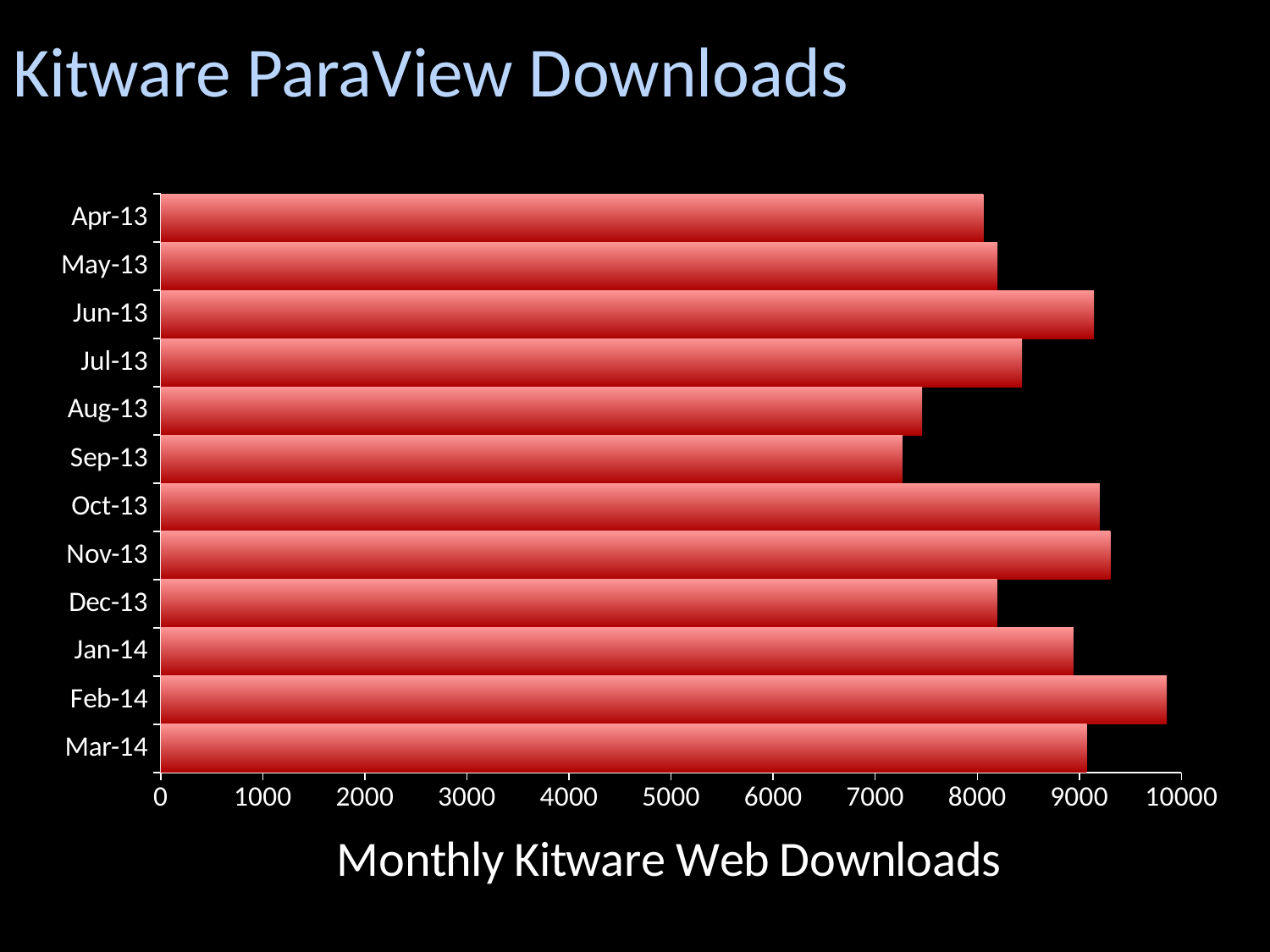
Is the value for Jul-13 greater or less than 8000? greater Which has more downloads, Nov-13 or Dec-13? Nov-13 What is the title of the slide? Kitware ParaView Downloads Is the value for Sep-13 greater or less than 8000? less How many months are plotted in the chart? 12 Which month has the highest number of downloads? Feb-14 Is the value for Feb-14 greater or less than 9000? greater Which has more downloads, Jun-13 or Aug-13? Jun-13 What kind of chart is shown on the slide? bar chart What is the label shown below the horizontal axis? Monthly Kitware Web Downloads Which month has the lowest number of downloads? Sep-13